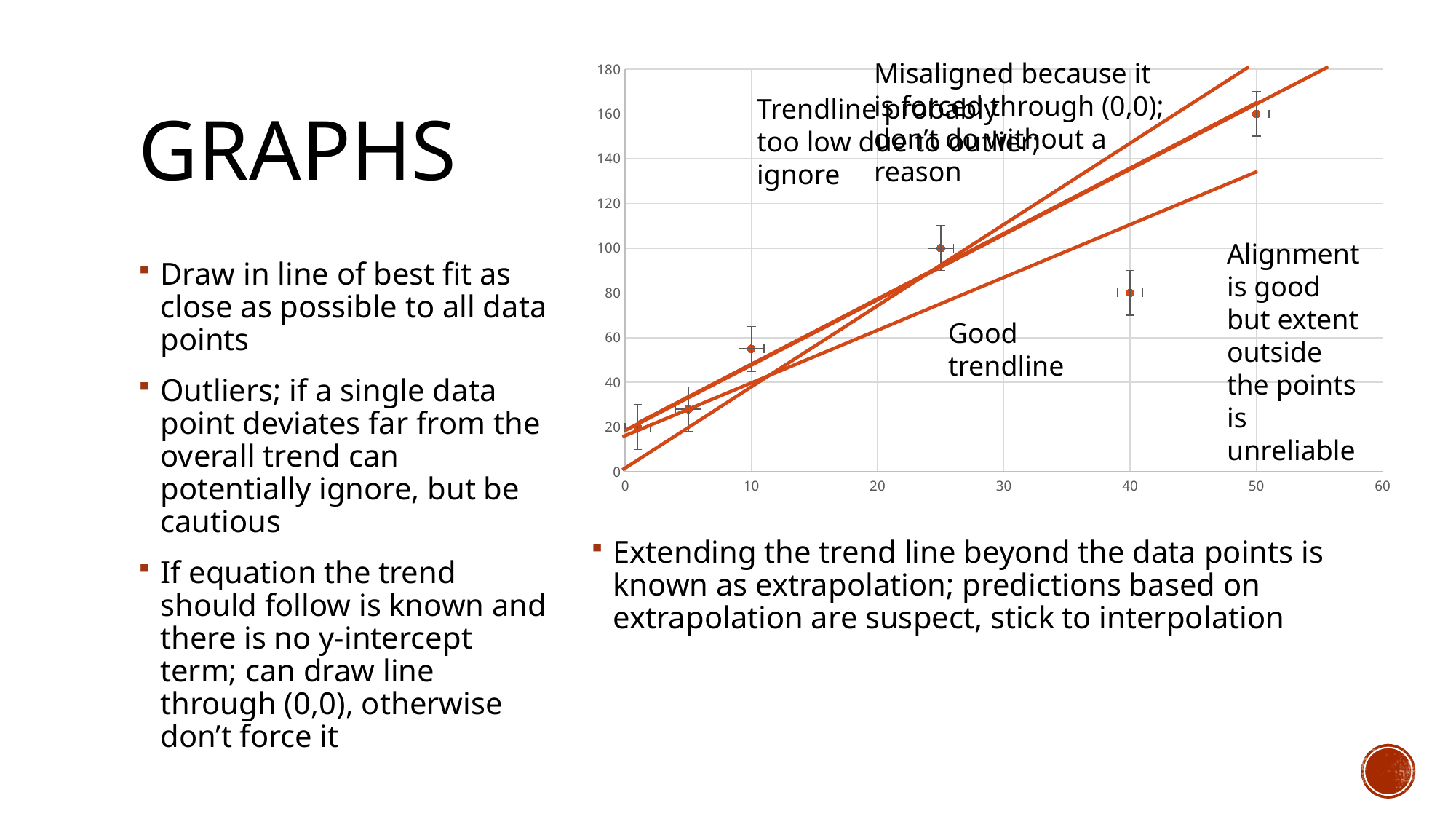
What is the y value of the data point at x = 50? 160 How many trendlines are drawn on the chart? 3 Which has the larger y value: the data point at x = 40 or the data point between x = 20 and x = 30? the point between x = 20 and x = 30 What is the y value of the data point at x = 40? 80 Do the data points generally rise or fall as x increases? rise Which data point has the highest y value? the point at x = 50 Is the y value of the data point at x = 10 greater or less than 40? greater What is the difference between the y values of the data points at x = 50 and x = 40? 80 What kind of chart is shown on the slide? scatter chart How many data points are plotted on the chart? 6 Is the y value of the data point at x = 5 greater or less than 40? less What is the maximum value shown on the y axis? 180